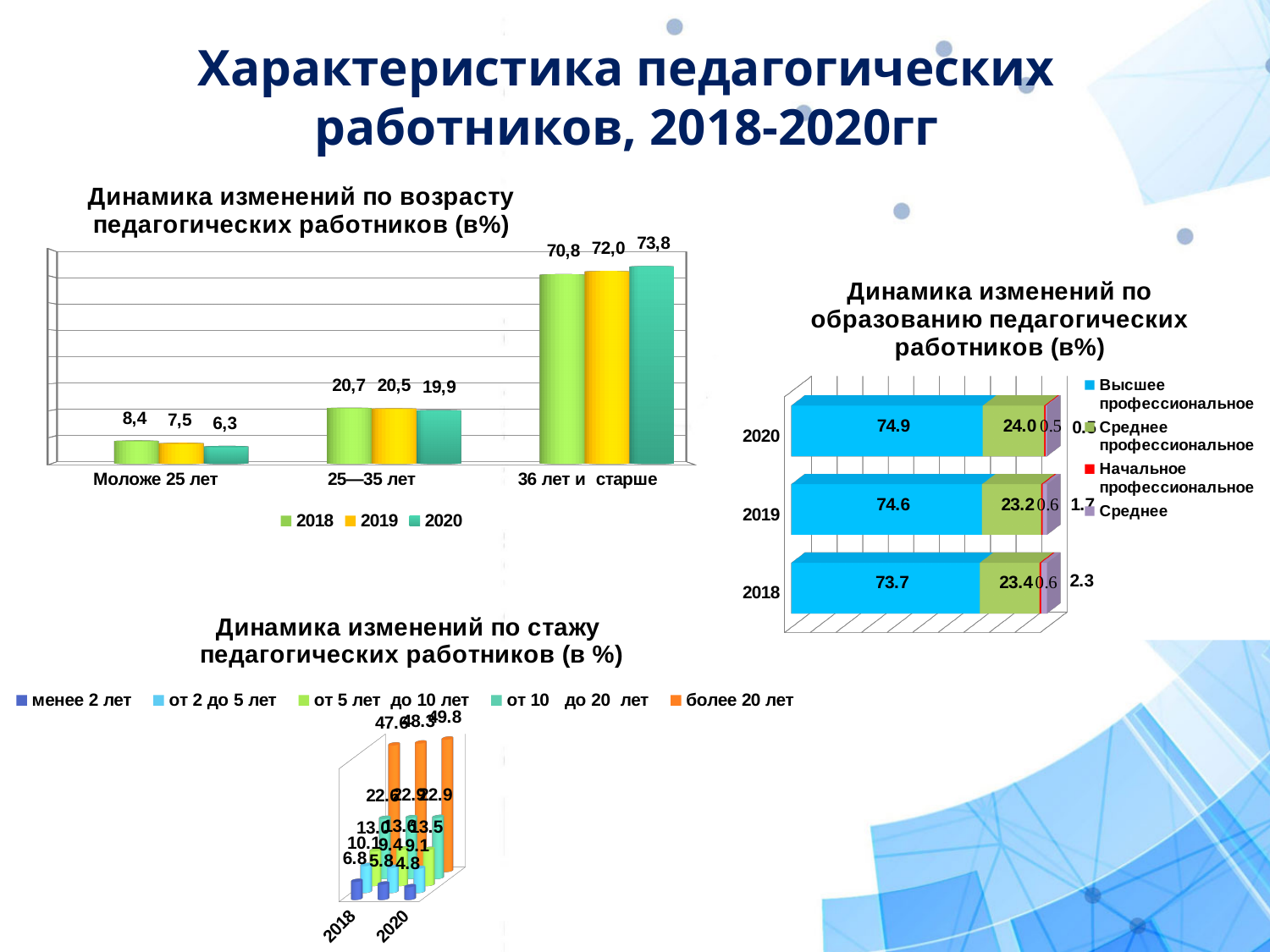
In the chart 'Динамика изменений по образованию педагогических работников (в%)', what is the value for 'Высшее профессиональное' in 2020? 74.9 In the chart 'Динамика изменений по образованию педагогических работников (в%)', what is the value for 'Среднее' in 2018? 2.3 How many series does the legend of the chart 'Динамика изменений по возрасту педагогических работников (в%)' list? 3 In the chart 'Динамика изменений по возрасту педагогических работников (в%)', does the value for 'Моложе 25 лет' rise or fall from 2018 to 2020? fall In the chart 'Динамика изменений по возрасту педагогических работников (в%)', what is the difference between the 2020 and 2018 values for '36 лет и старше'? 3,0 In the chart 'Динамика изменений по образованию педагогических работников (в%)', which is larger: 'Среднее профессиональное' in 2019 or in 2018? 2018 In the chart 'Динамика изменений по возрасту педагогических работников (в%)', what is the value for 'Моложе 25 лет' in 2018? 8,4 How many series does the legend of the chart 'Динамика изменений по стажу педагогических работников (в %)' list? 5 In the chart 'Динамика изменений по возрасту педагогических работников (в%)', which age category has the highest value in 2019? 36 лет и старше In the chart 'Динамика изменений по возрасту педагогических работников (в%)', what is the value for '36 лет и старше' in 2020? 73,8 What kind of chart is 'Динамика изменений по образованию педагогических работников (в%)'? stacked bar chart How many series does the legend of the chart 'Динамика изменений по образованию педагогических работников (в%)' list? 4